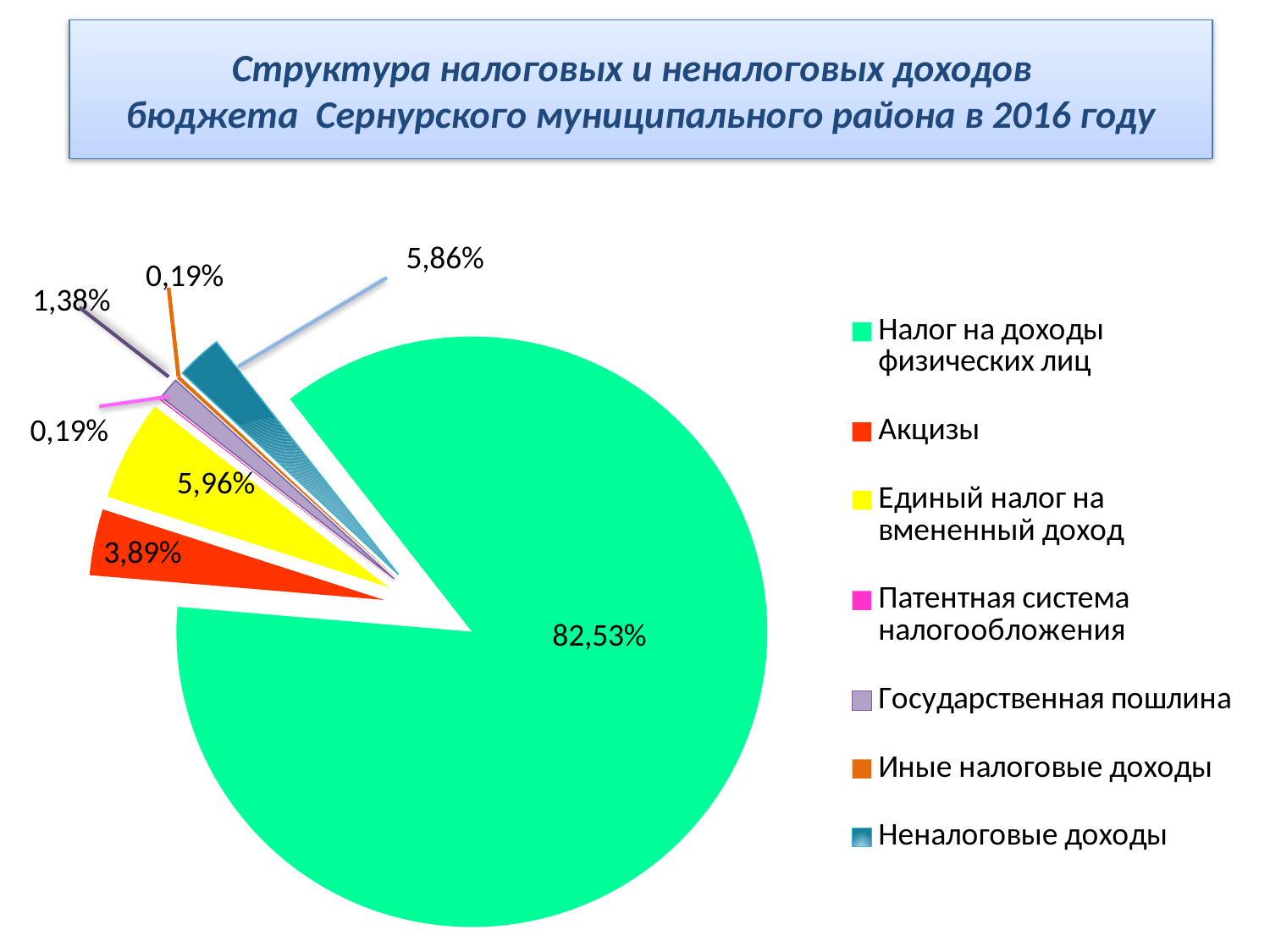
What type of chart is shown on the slide? Pie chart What is the difference between the shares of "Единый налог на вмененный доход" and "Акцизы"? 2,07% Which is larger: "Единый налог на вмененный доход" or "Неналоговые доходы"? Единый налог на вмененный доход Which colour represents "Акцизы" in the pie chart? Red What share of the pie does "Налог на доходы физических лиц" have? 82,53% What is the value shown for "Неналоговые доходы"? 5,86% How many categories does the legend list? 7 What is the value shown for "Государственная пошлина"? 1,38% What is the value shown for "Единый налог на вмененный доход"? 5,96% Which category has the largest share of the pie? Налог на доходы физических лиц What is the value shown for "Акцизы"? 3,89% What is the difference between the shares of "Неналоговые доходы" and "Государственная пошлина"? 4,48%